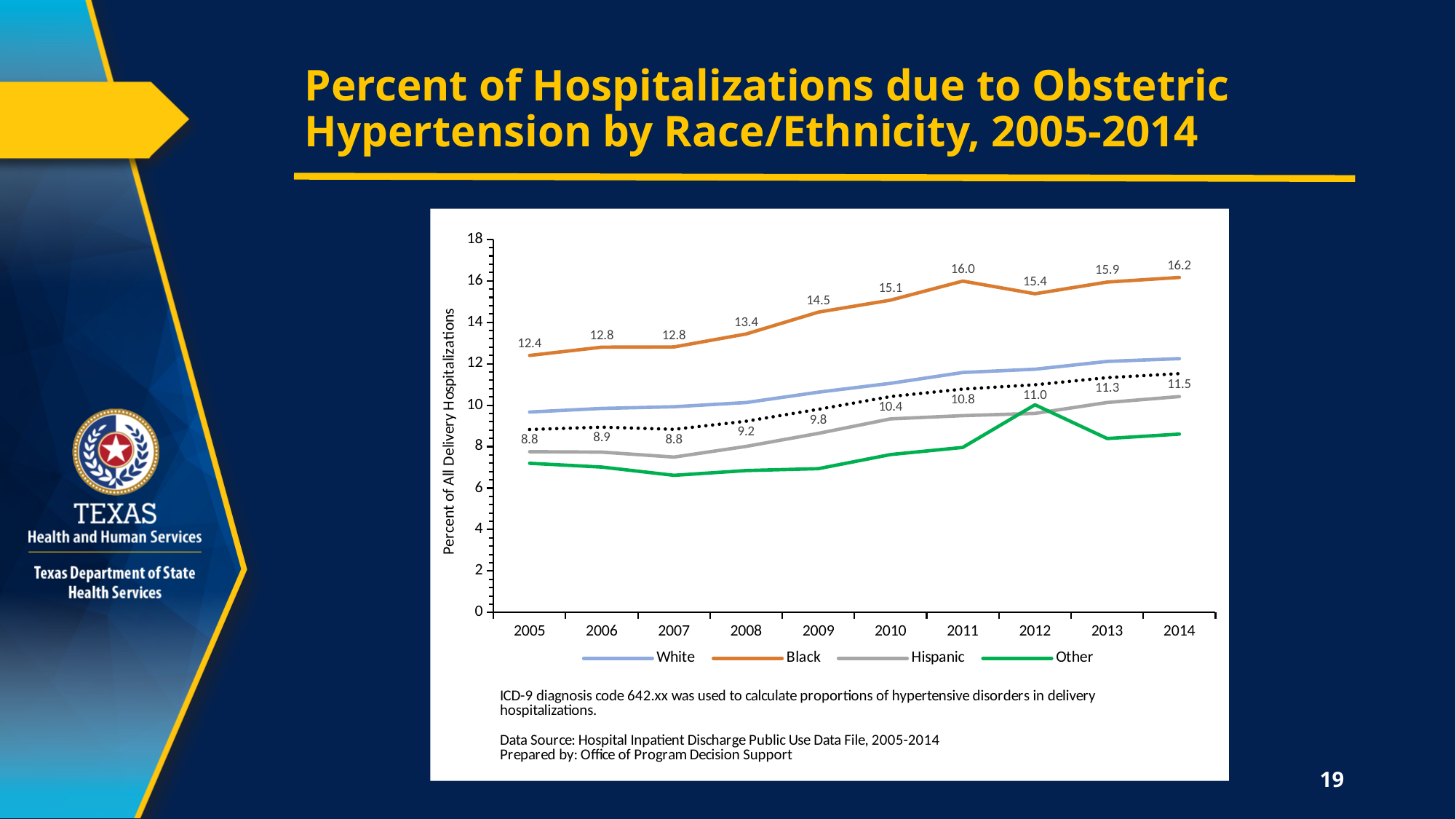
What is the value for Black in 2005? 12.4 How many series does the legend list? 4 In which year is the Black series at its highest? 2014 Is the value for Other in 2007 greater or less than 8? less What is the difference between the Black values in 2014 and 2005? 3.8 In which year is the Black series at its lowest? 2005 What is the value for Black in 2014? 16.2 What kind of chart is shown on the slide? line chart What is the value for Black in 2009? 14.5 How many years are shown on the x axis? 10 Does the Black series generally rise or fall from 2005 to 2014? rise Which year has the larger Black value, 2011 or 2012? 2011